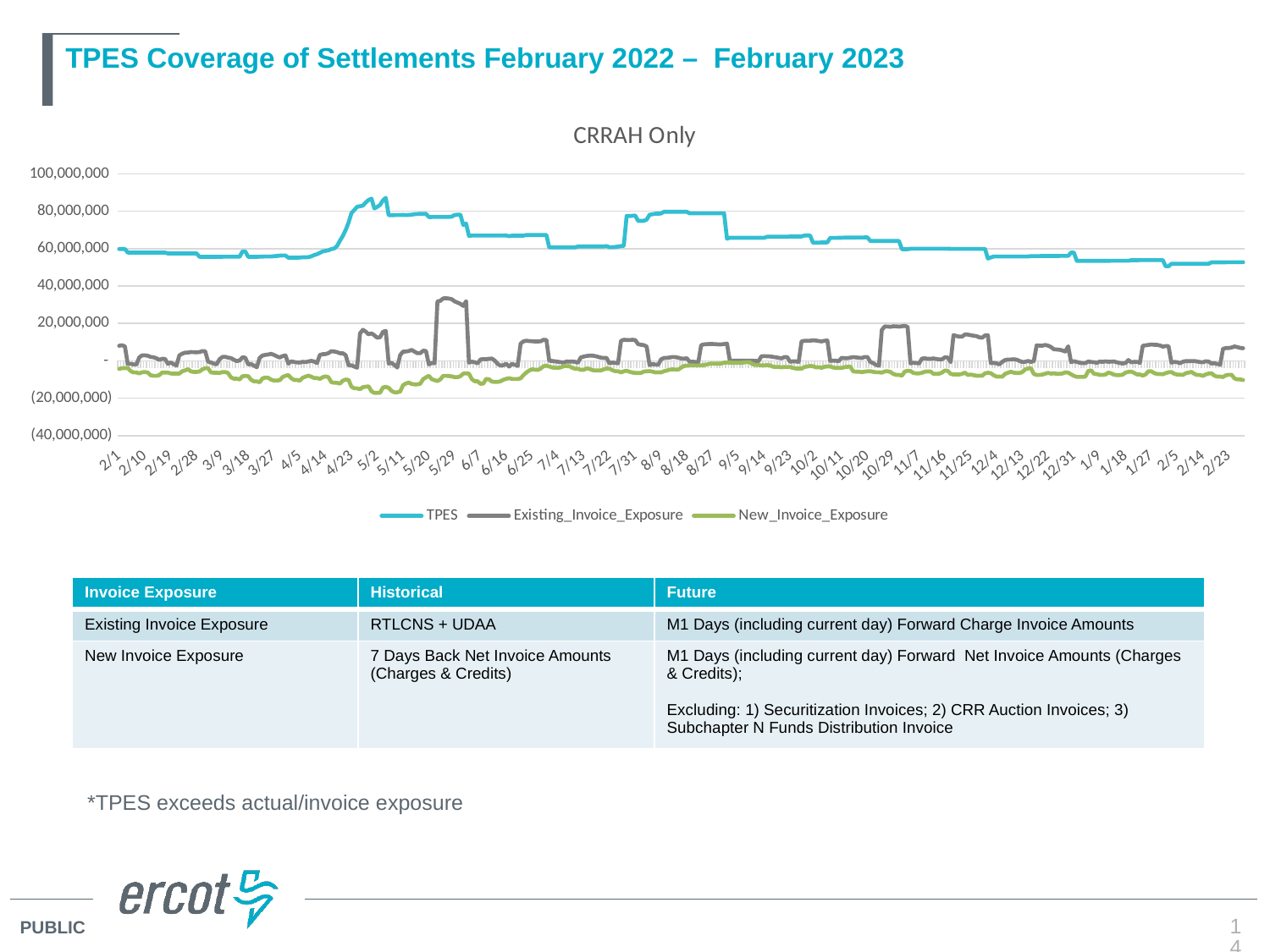
What kind of chart is shown on the slide? line chart Is the peak value of Existing_Invoice_Exposure around 5/20 greater or less than 20,000,000? greater Which series has the highest values throughout the chart? TPES Is the value of TPES at 2/1 greater or less than 40,000,000? greater Which series is plotted with the green line? New_Invoice_Exposure Is the peak value of TPES around 5/2 greater or less than 80,000,000? greater Which series has the lowest values for most of the chart? New_Invoice_Exposure What is the title of the chart? CRRAH Only How many series does the chart legend list? 3 Does the TPES line rise or fall from 9/5 to 2/23? fall Which is larger at 8/9, TPES or Existing_Invoice_Exposure? TPES